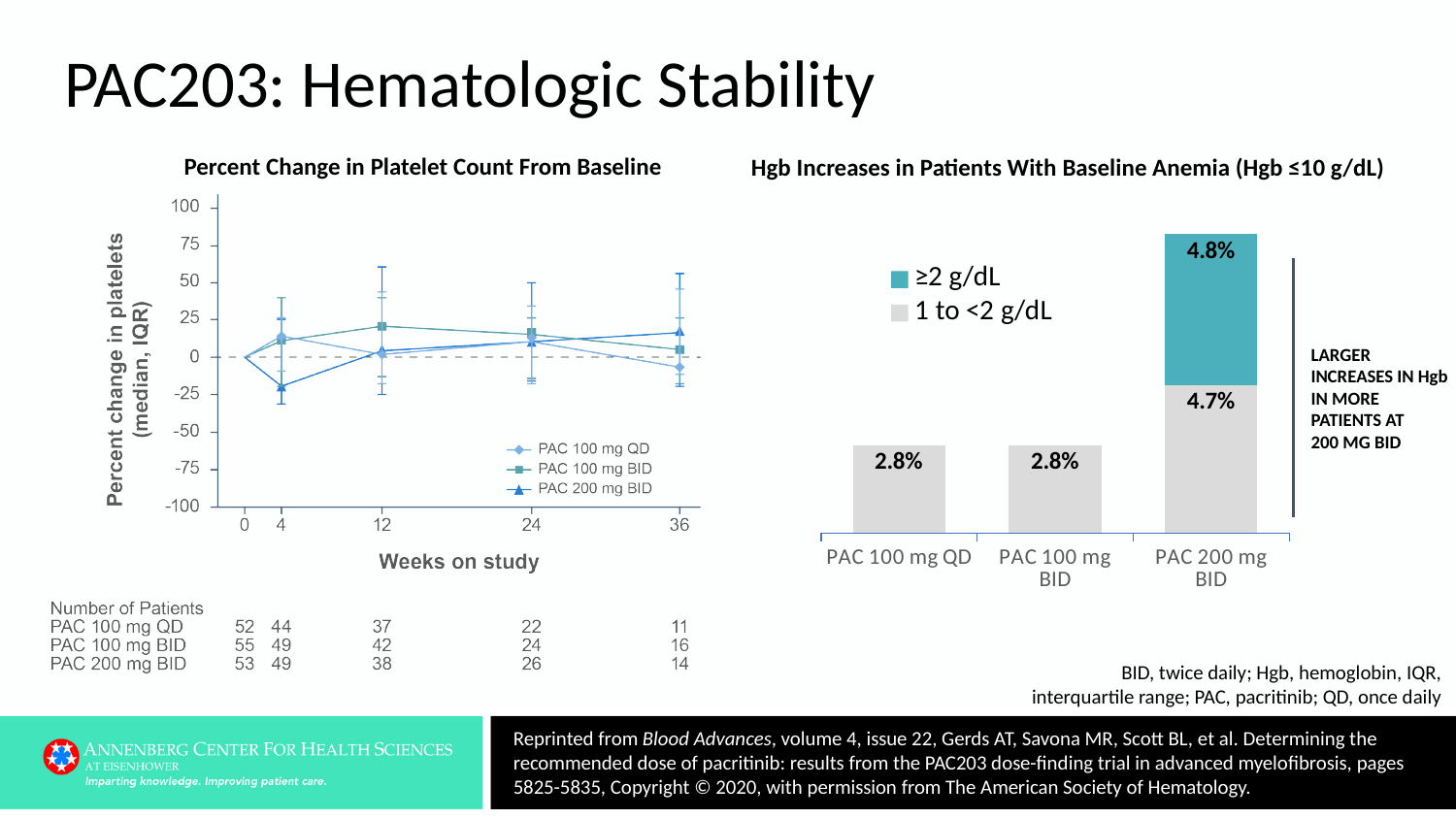
In the 'Hgb Increases in Patients With Baseline Anemia' chart, what is the total height of the stacked bar for PAC 200 mg BID? 9.5% In the 'Hgb Increases in Patients With Baseline Anemia' chart, how many dose groups are shown on the x axis? 3 In the 'Percent Change in Platelet Count From Baseline' chart, is the median value for PAC 200 mg BID at week 4 greater or less than 0? less In the 'Hgb Increases in Patients With Baseline Anemia' chart, what is the value shown for PAC 100 mg QD? 2.8% In the 'Percent Change in Platelet Count From Baseline' chart, how many series does the legend list? 3 In the 'Hgb Increases in Patients With Baseline Anemia' chart, what is the value of the '1 to <2 g/dL' segment for PAC 200 mg BID? 4.7% In the 'Hgb Increases in Patients With Baseline Anemia' chart, what is the difference between the '≥2 g/dL' segment and the '1 to <2 g/dL' segment for PAC 200 mg BID? 0.1% In the 'Hgb Increases in Patients With Baseline Anemia' chart, what is the value of the '≥2 g/dL' segment for PAC 200 mg BID? 4.8% What kind of chart is 'Percent Change in Platelet Count From Baseline'? Line chart In the 'Percent Change in Platelet Count From Baseline' chart, what is the label of the x axis? Weeks on study In the 'Hgb Increases in Patients With Baseline Anemia' chart, which dose group has the tallest bar? PAC 200 mg BID In the 'Hgb Increases in Patients With Baseline Anemia' chart, how many categories does the legend list? 2